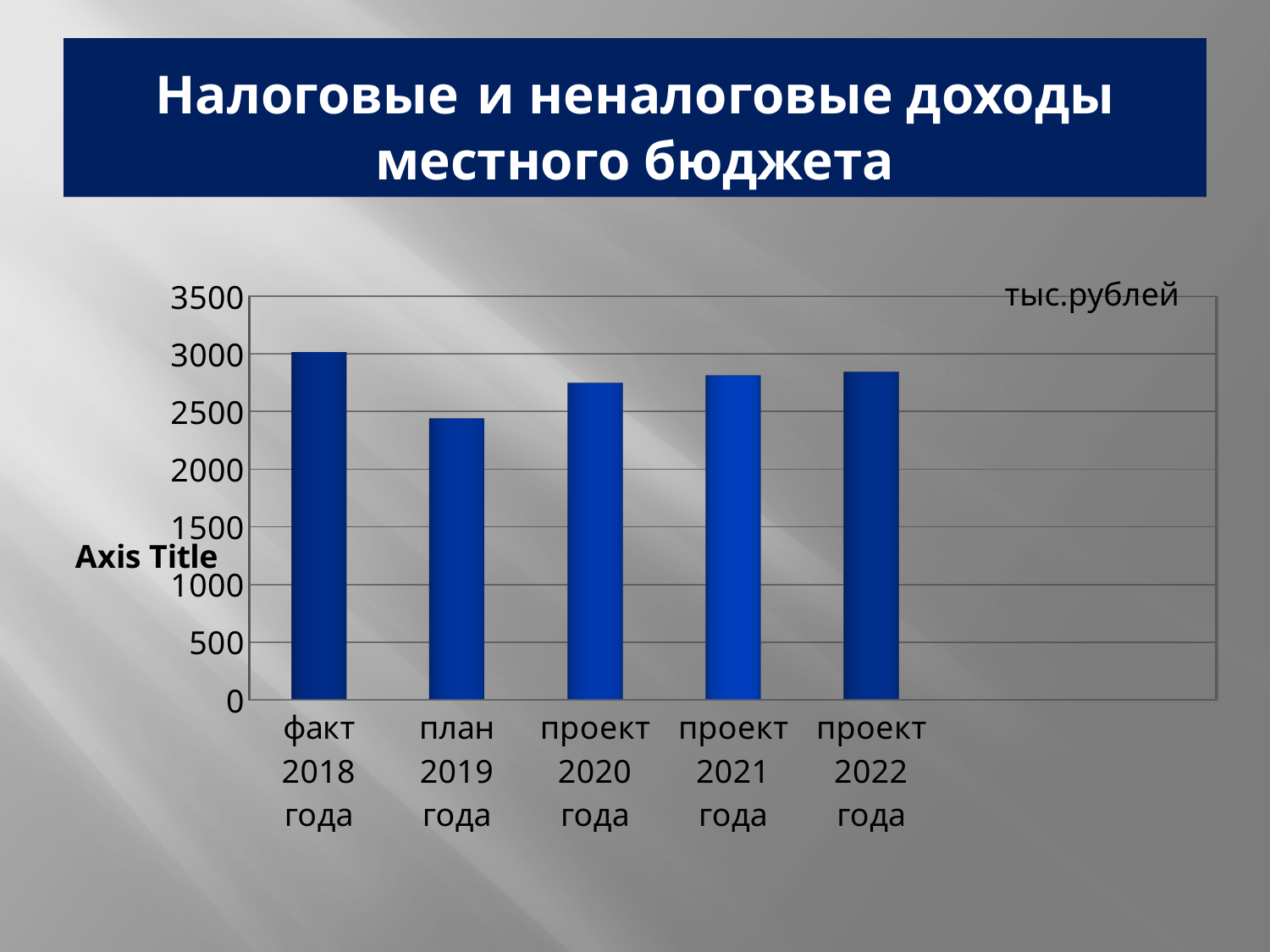
Which is larger, the value for факт 2018 года or the value for план 2019 года? факт 2018 года Which category has the highest value in the chart? факт 2018 года How many categories (bars) are shown in the chart? 5 Which is larger, the value for план 2019 года or the value for проект 2020 года? проект 2020 года Which category has the lowest value in the chart? план 2019 года Is the value for план 2019 года greater or less than 2500? less What is the title of the slide? Налоговые и неналоговые доходы местного бюджета What unit is indicated in the top right corner of the chart? тыс.рублей Is the value for проект 2022 года greater or less than 3000? less Is the value for проект 2020 года greater or less than 2500? greater What kind of chart is shown on the slide? bar chart